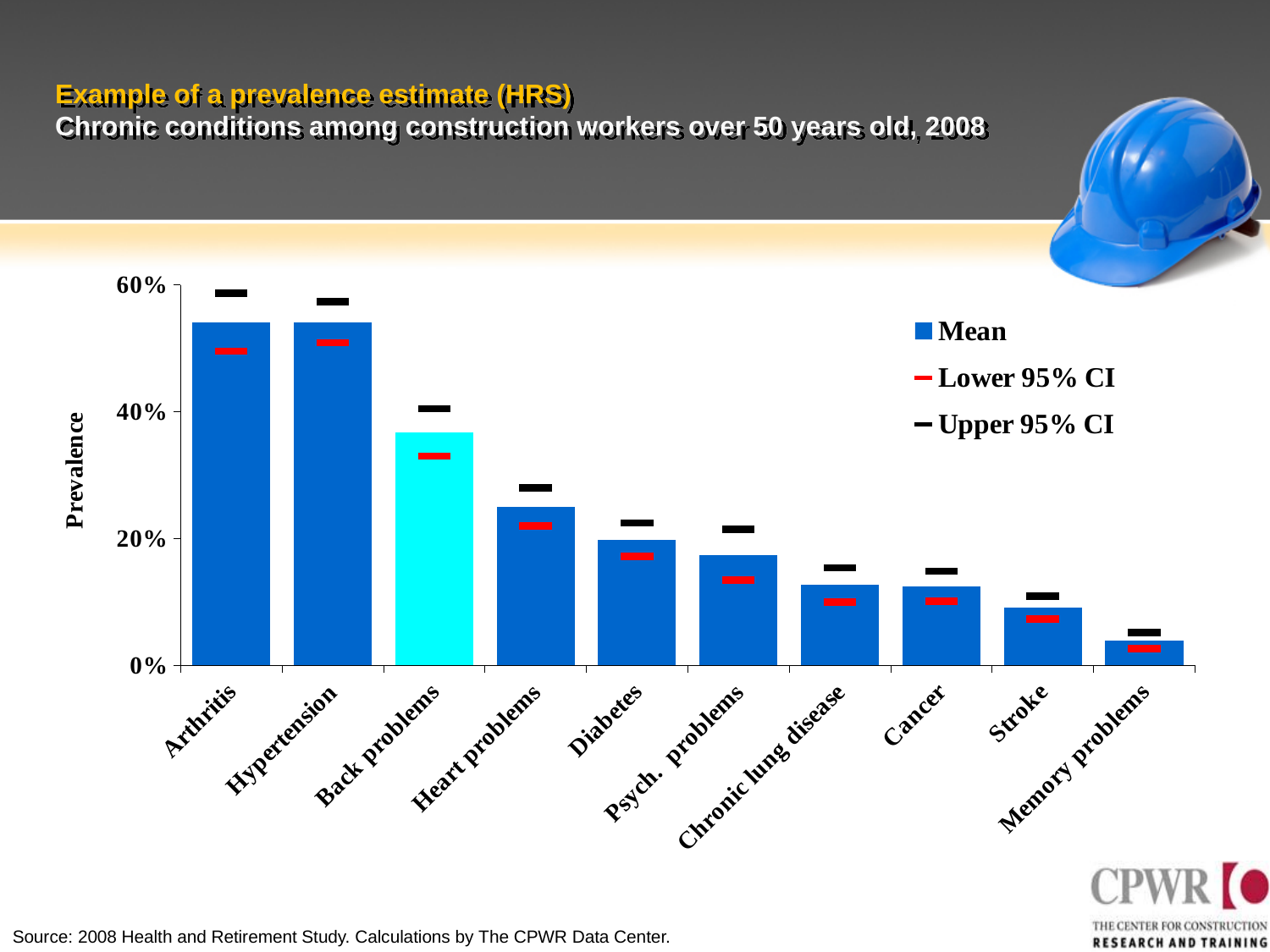
What kind of chart is shown on the slide? bar chart How many chronic conditions are shown along the x axis of the chart? 10 Is the mean prevalence for Stroke greater or less than 20%? less Do the mean prevalence values rise or fall moving from left to right along the x axis? fall Which chronic condition has the lowest mean prevalence in the chart? Memory problems Which has a higher mean prevalence, Back problems or Heart problems? Back problems Is the mean prevalence for Arthritis greater or less than 40%? greater What is the label on the chart's vertical axis? Prevalence Which chronic condition's bar is highlighted in cyan rather than blue? Back problems Is the mean prevalence for Back problems greater or less than 40%? less How many series does the chart's legend list? 3